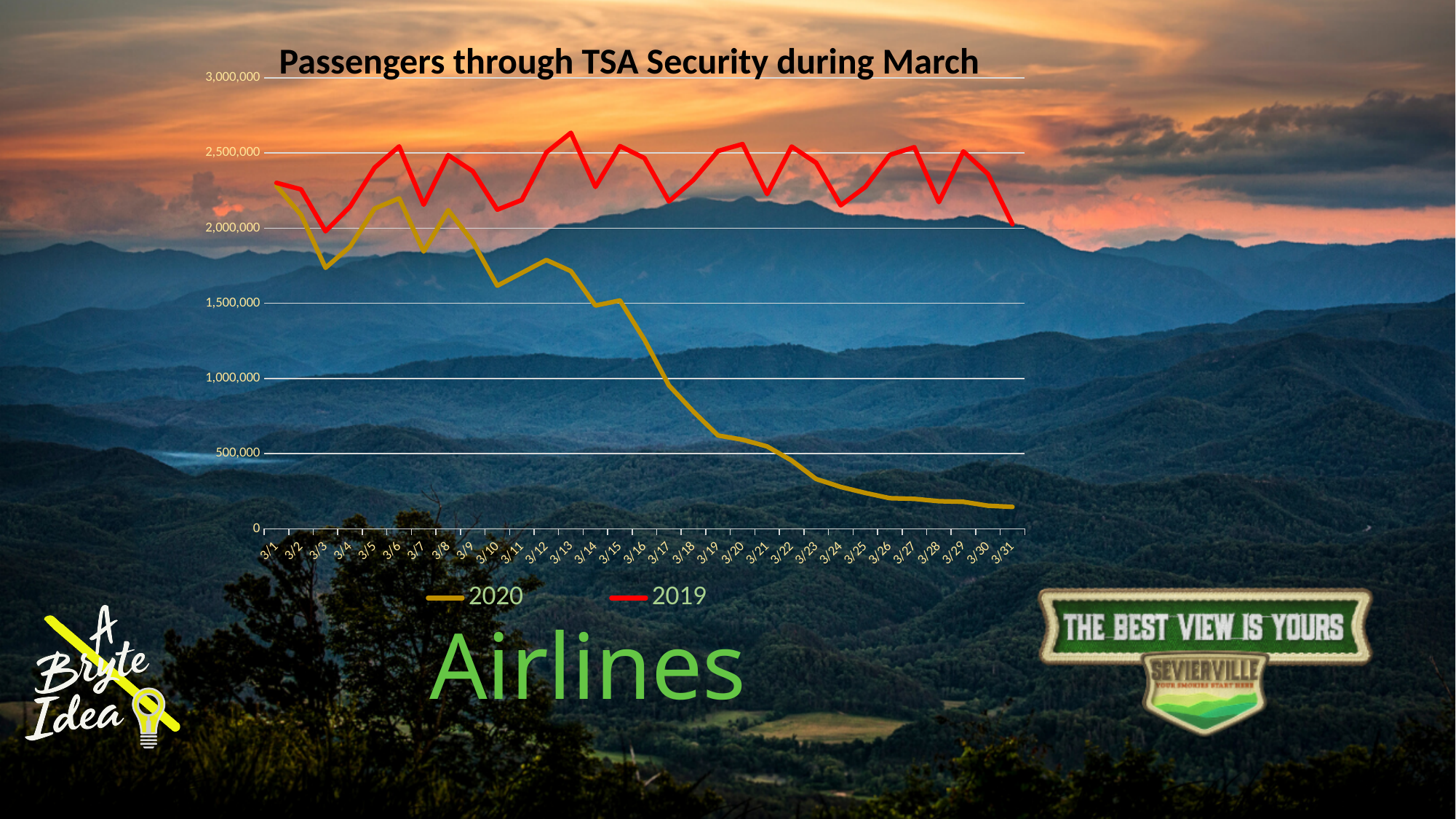
What kind of chart is shown on the slide? line chart Is the 2019 value on 3/13 greater or less than 2,500,000? greater On 3/31, which series has the larger value, 2019 or 2020? 2019 How many series does the legend list? 2 On which date does the 2020 series reach its lowest value? 3/31 Is the 2020 value on 3/18 greater or less than 1,000,000? less Is the 2019 value on 3/1 greater or less than 2,000,000? greater How many dates are plotted along the x axis? 31 Which colour is used for the 2019 series? red Does the 2020 series rise or fall over the course of March? fall What is the title of the chart? Passengers through TSA Security during March